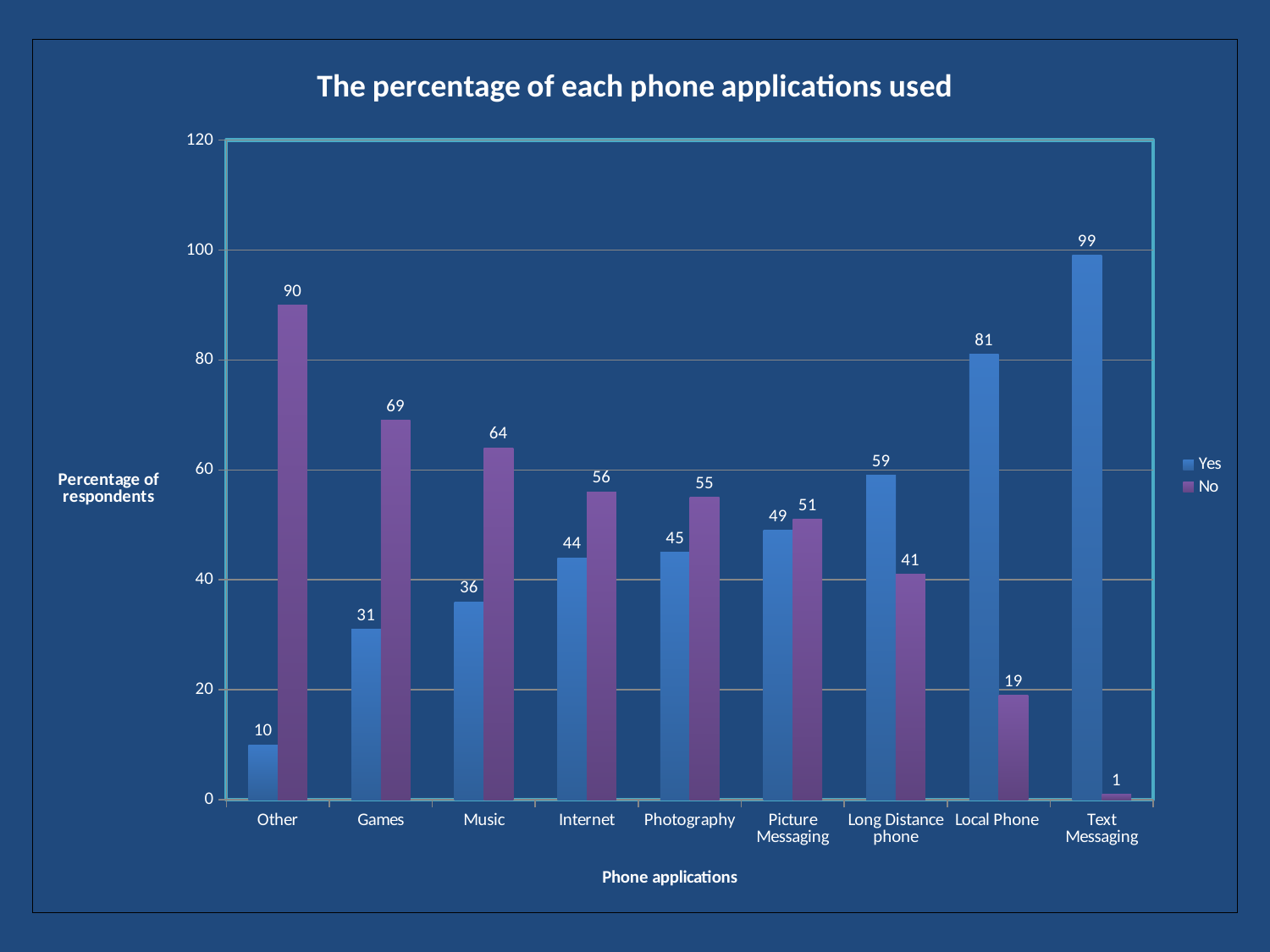
What is the difference between the 'No' and 'Yes' values for Other? 80 How many phone application categories are shown on the x axis? 9 How many series does the legend list? 2 What is the 'Yes' value for Long Distance phone? 59 What kind of chart is shown on the slide? Bar chart What is the 'No' value for Games? 69 Is the 'Yes' value for Local Phone greater or less than 80? greater Which phone application has the lowest 'No' value? Text Messaging What is the 'Yes' value for Text Messaging? 99 What is the title of the chart? The percentage of each phone applications used Which phone application has the highest 'Yes' value? Text Messaging Which is larger for Music, the 'Yes' value or the 'No' value? No